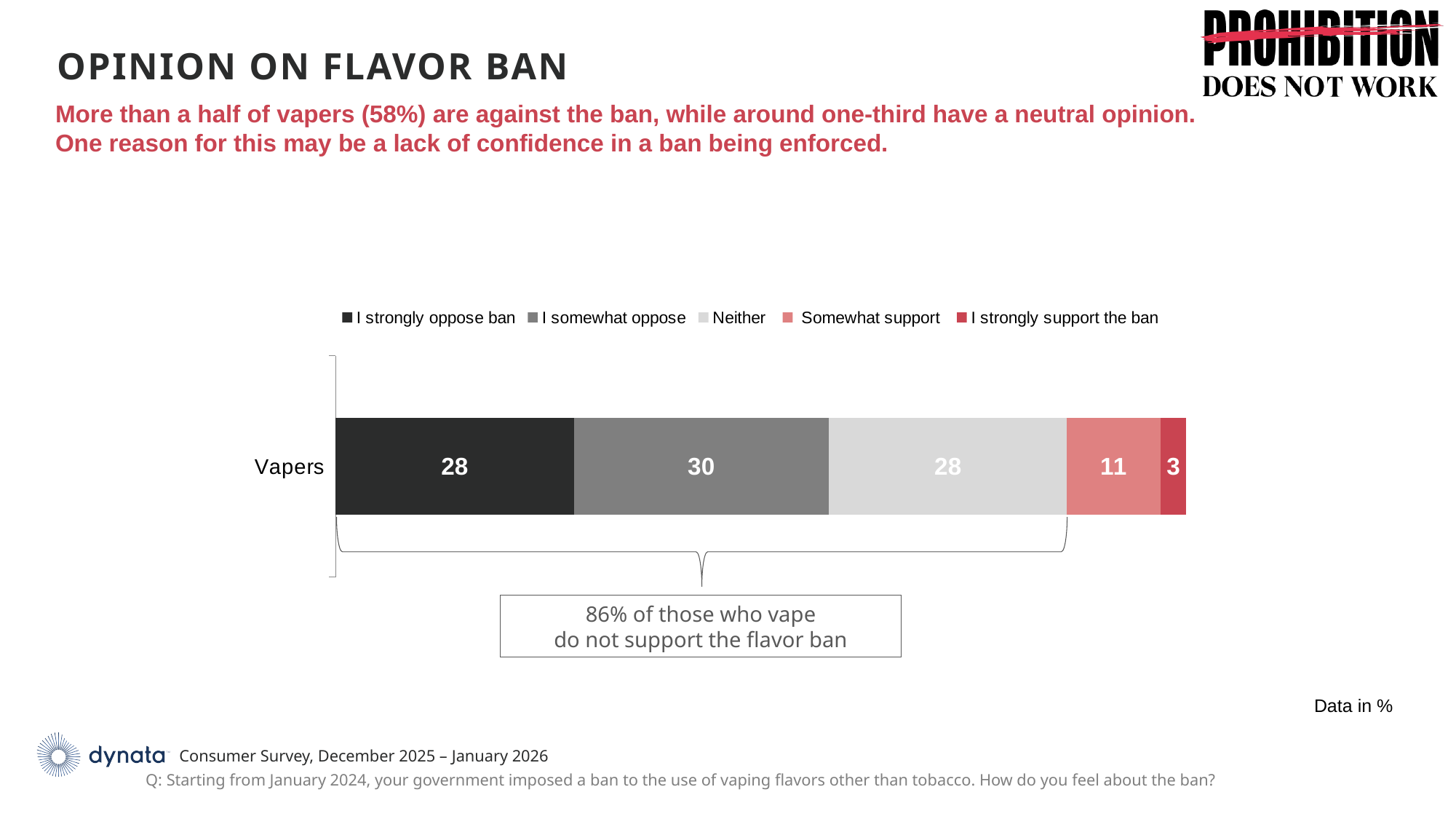
Which is larger: the value for "I somewhat oppose" or the value for "Somewhat support"? I somewhat oppose Which series has the highest value in the Vapers bar? I somewhat oppose What is the value for "I strongly support the ban" in the Vapers bar? 3 What is the value for "Neither" in the Vapers bar? 28 What is the total of the Vapers stacked bar? 100 Which series has the lowest value in the Vapers bar? I strongly support the ban What is the combined value of "I strongly oppose ban" and "I somewhat oppose"? 58 What is the difference between the "Somewhat support" and "I strongly support the ban" values? 8 What kind of chart is shown on the slide? Stacked bar chart How many series does the legend list? 5 What is the value for "Somewhat support" in the Vapers bar? 11 What is the value for "I somewhat oppose" in the Vapers bar? 30